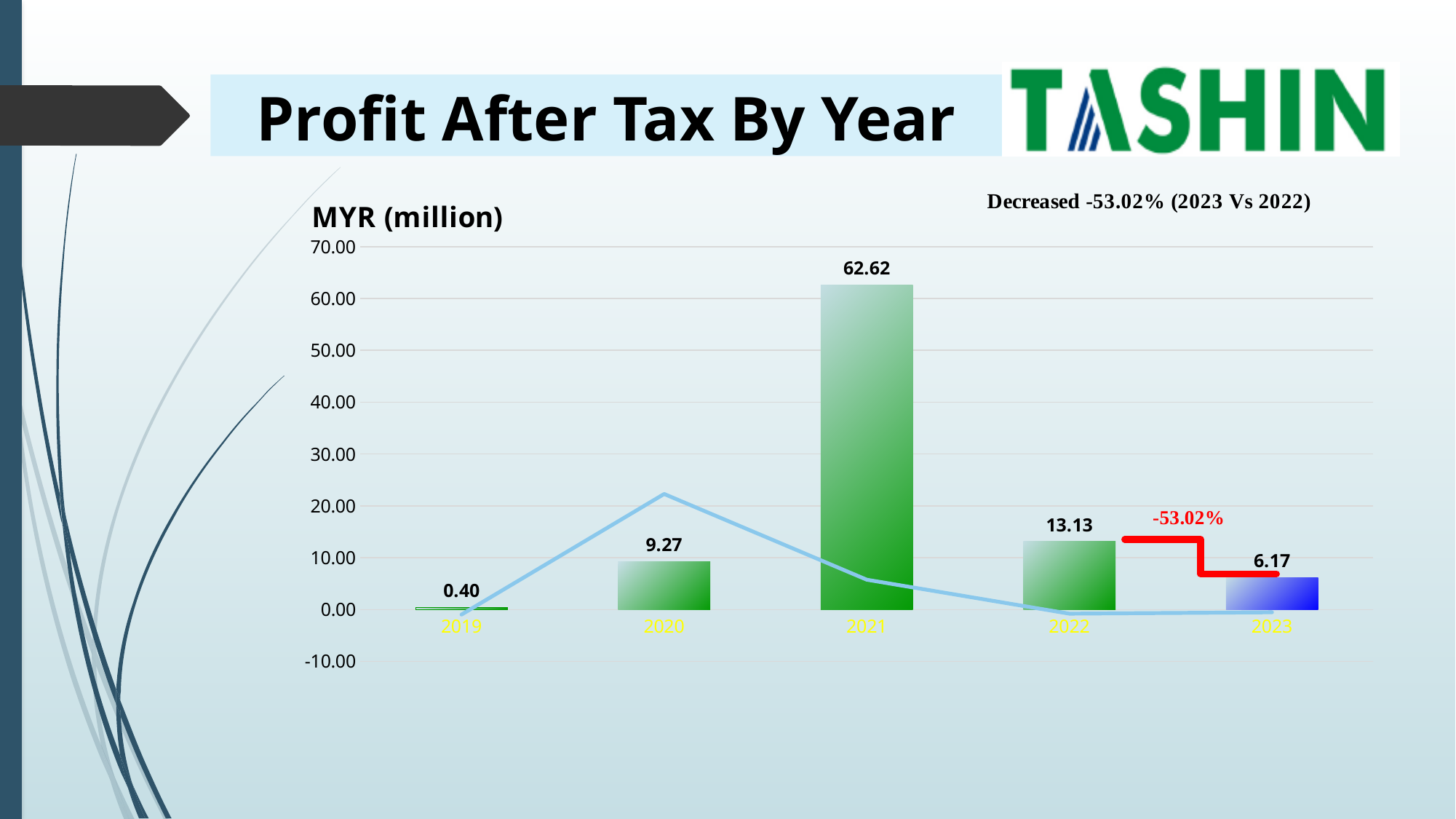
How many years are shown on the x axis of the chart? 5 What is the profit after tax for 2021? 62.62 What kind of chart is used to show profit after tax by year? bar chart What is the profit after tax for 2019? 0.40 What unit is stated above the y axis of the chart? MYR (million) What is the difference between the profit after tax in 2021 and in 2022? 49.49 Which year has the lowest profit after tax? 2019 Which year has the highest profit after tax? 2021 What is the difference between the profit after tax in 2022 and in 2023? 6.96 Which year has a larger profit after tax, 2020 or 2022? 2022 What is the profit after tax for 2023? 6.17 Is the value for 2021 greater or less than 60.00? greater